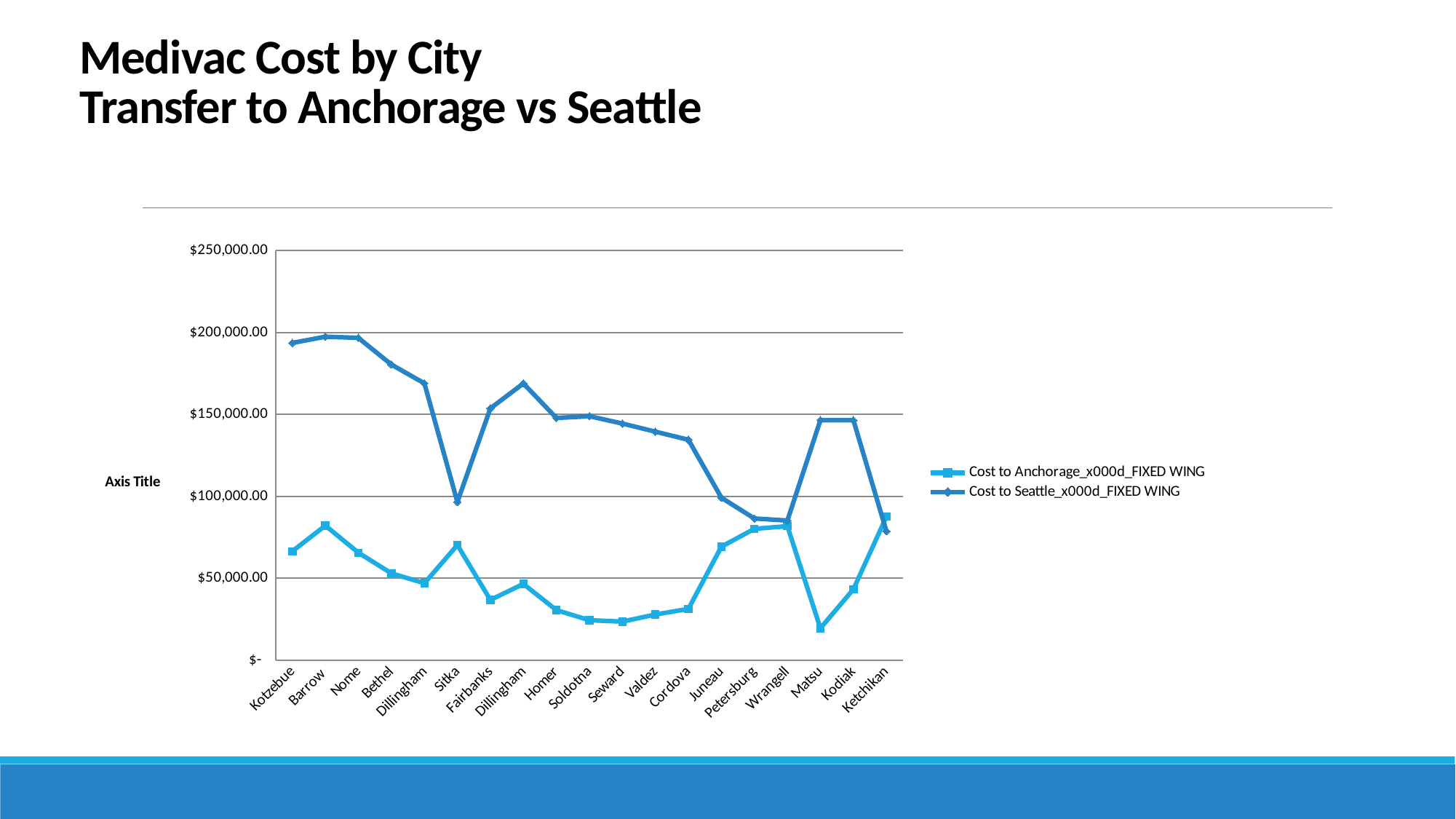
What kind of chart is shown on the slide? line chart How many cities are plotted along the x axis? 19 Does the Cost to Seattle_x000d_FIXED WING rise or fall from Kotzebue to Sitka? fall Is the Cost to Anchorage_x000d_FIXED WING for Soldotna greater or less than $50,000.00? less Is the Cost to Anchorage_x000d_FIXED WING for Matsu greater or less than $50,000.00? less How many series does the legend list? 2 What is the title of the slide? Medivac Cost by City Transfer to Anchorage vs Seattle Which city has the lowest Cost to Anchorage_x000d_FIXED WING? Matsu Is the Cost to Seattle_x000d_FIXED WING for Kotzebue greater or less than $150,000.00? greater What text is shown as the vertical axis title? Axis Title For Kotzebue, which is larger: Cost to Anchorage_x000d_FIXED WING or Cost to Seattle_x000d_FIXED WING? Cost to Seattle_x000d_FIXED WING